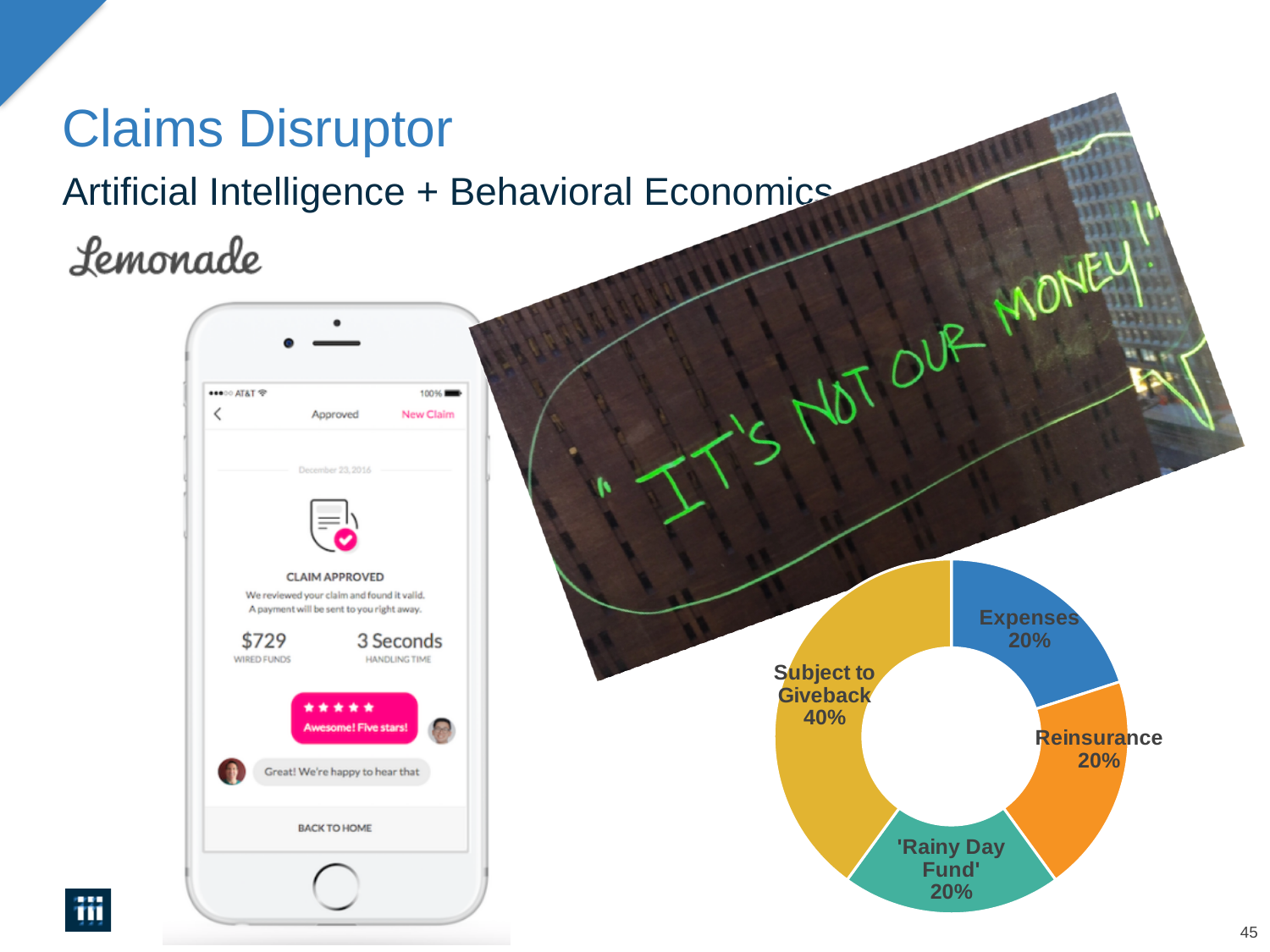
What percentage is shown for the 'Rainy Day Fund' slice? 20% What is the difference between the Subject to Giveback share and the Expenses share? 20% What share of the pie chart is labelled 'Subject to Giveback'? 40% What is the combined share of Expenses, Reinsurance and 'Rainy Day Fund' in the pie chart? 60% Which slice of the pie chart is the largest? Subject to Giveback Which is larger in the pie chart, Subject to Giveback or Reinsurance? Subject to Giveback What colour is the Expenses slice in the pie chart? Blue How many slices does the pie chart have? 4 What kind of chart is shown on the slide? Pie chart (donut) What percentage is shown for Expenses in the pie chart? 20% What percentage is shown for Reinsurance in the pie chart? 20% What colour is the Subject to Giveback slice in the pie chart? Yellow